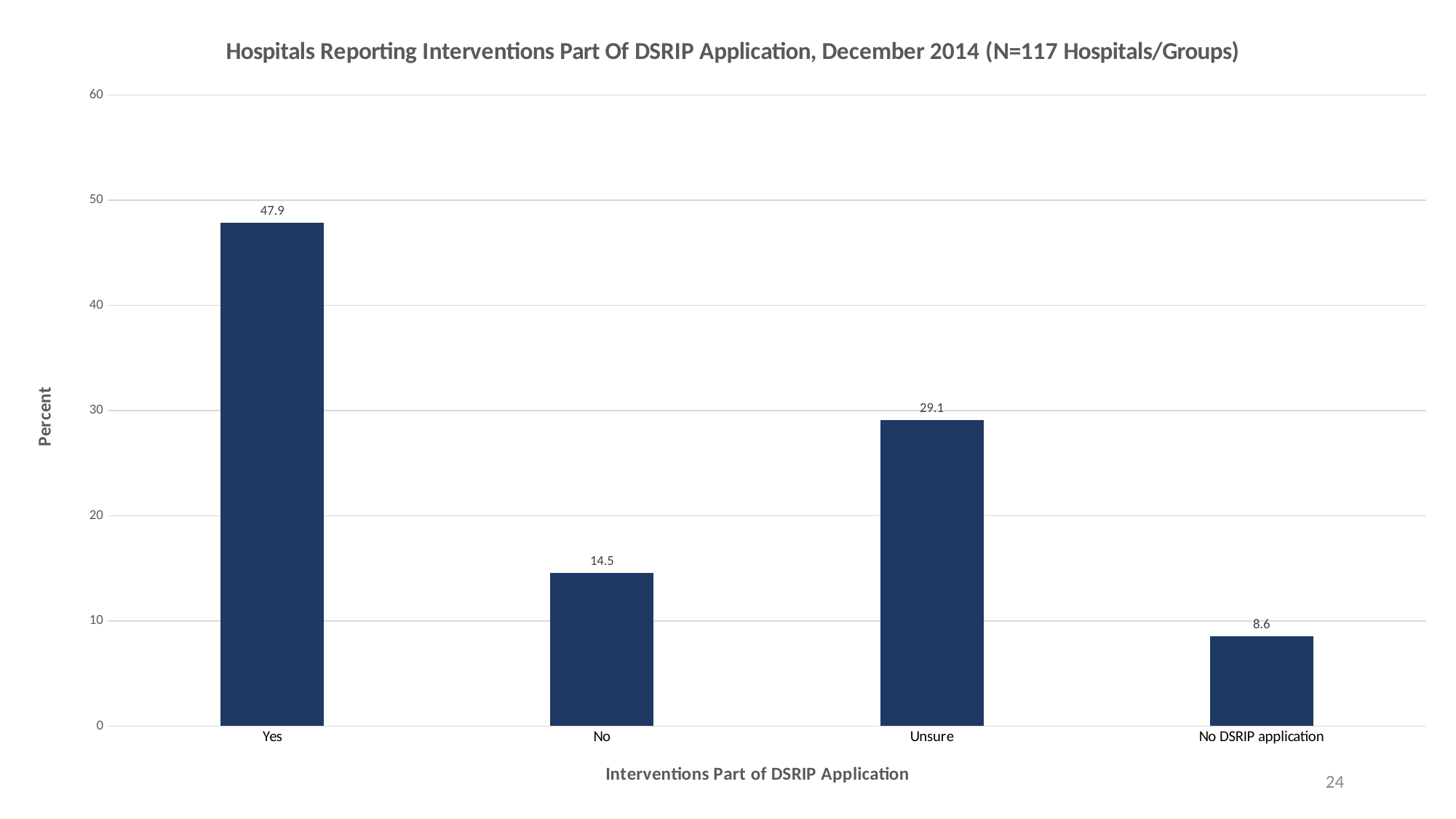
Which category has the lowest value? No DSRIP application Is the value for No greater or less than 20? less What percent of hospitals answered Yes? 47.9 Which is larger, the value for No or the value for Unsure? Unsure What is the value for No DSRIP application? 8.6 What kind of chart is shown on the slide? Bar chart What is the label of the y axis? Percent How many categories are shown on the x axis? 4 Which category has the highest value? Yes What is the difference between the Yes and Unsure values? 18.8 What is the difference between the No and No DSRIP application values? 5.9 What is the value for the Unsure category? 29.1